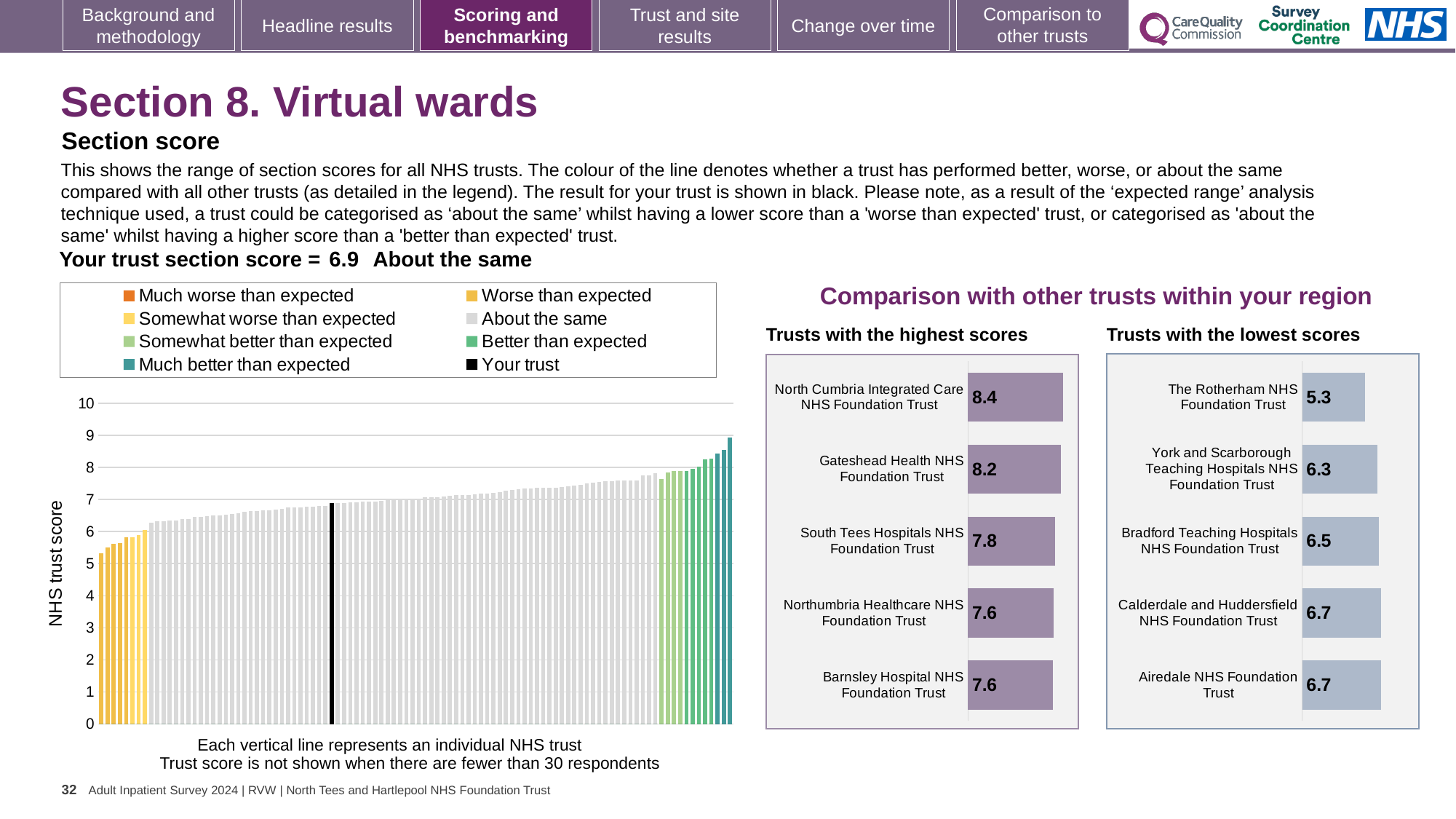
In the 'Trusts with the highest scores' chart, which trust has the lowest score shown? Northumbria Healthcare NHS Foundation Trust and Barnsley Hospital NHS Foundation Trust (7.6) In the 'Trusts with the lowest scores' chart, which trust has the highest score shown? Calderdale and Huddersfield NHS Foundation Trust and Airedale NHS Foundation Trust (6.7) In the NHS trust score chart on the left, do the bar values rise or fall from left to right? Rise In the NHS trust score chart on the left, is the value of the tallest bar greater or less than 8? greater How many entries does the legend of the NHS trust score chart on the left list? 8 In the 'Trusts with the highest scores' chart, what is the difference between the scores of North Cumbria Integrated Care NHS Foundation Trust and South Tees Hospitals NHS Foundation Trust? 0.6 In the 'Trusts with the lowest scores' chart, what is the difference between the scores of Airedale NHS Foundation Trust and The Rotherham NHS Foundation Trust? 1.4 In the 'Trusts with the lowest scores' chart, what is the score for The Rotherham NHS Foundation Trust? 5.3 What kind of chart is the 'Trusts with the lowest scores' chart? Bar chart How many trusts are listed in the 'Trusts with the highest scores' chart? 5 In the 'Trusts with the lowest scores' chart, which has the higher score: York and Scarborough Teaching Hospitals NHS Foundation Trust or Bradford Teaching Hospitals NHS Foundation Trust? Bradford Teaching Hospitals NHS Foundation Trust In the 'Trusts with the highest scores' chart, what is the score for North Cumbria Integrated Care NHS Foundation Trust? 8.4